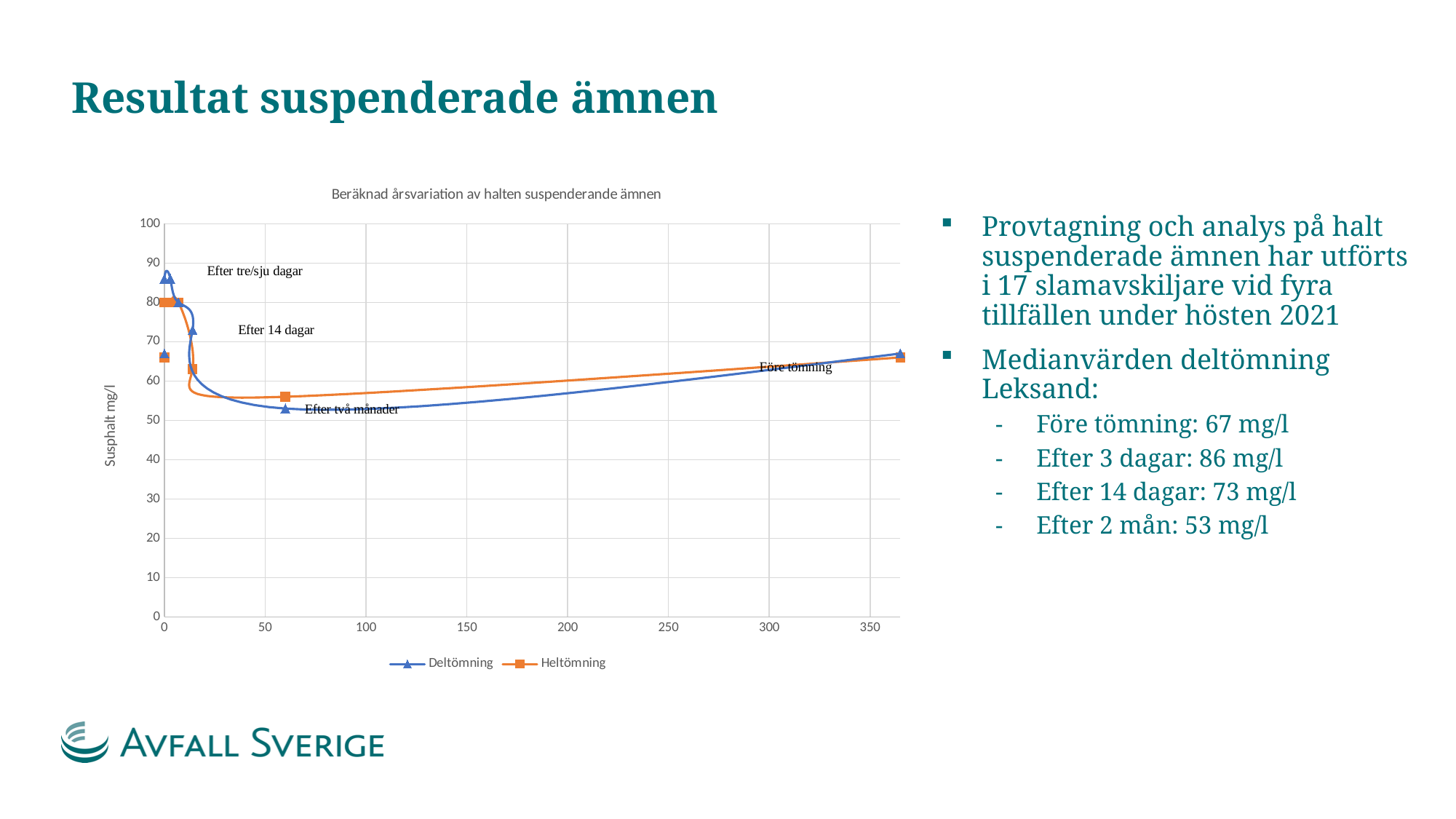
Does the Deltömning series rise or fall between the point labelled "Efter 14 dagar" and the point labelled "Efter två månader"? fall How many series does the chart legend list? 2 At around day 60, which series has the higher value, Deltömning or Heltömning? Heltömning Is the Deltömning value at the point labelled "Efter 14 dagar" greater or less than 70? greater What is the title of the chart? Beräknad årsvariation av halten suspenderande ämnen What are the two series named in the chart legend? Deltömning and Heltömning Do the values of both series rise or fall between day 60 and day 350? rise Is the highest Deltömning value (near "Efter tre/sju dagar") greater or less than 80? greater Is the Deltömning value at the point labelled "Efter två månader" greater or less than 60? less What kind of chart is shown on the slide? line chart At around day 14, which series has the higher value, Deltömning or Heltömning? Deltömning